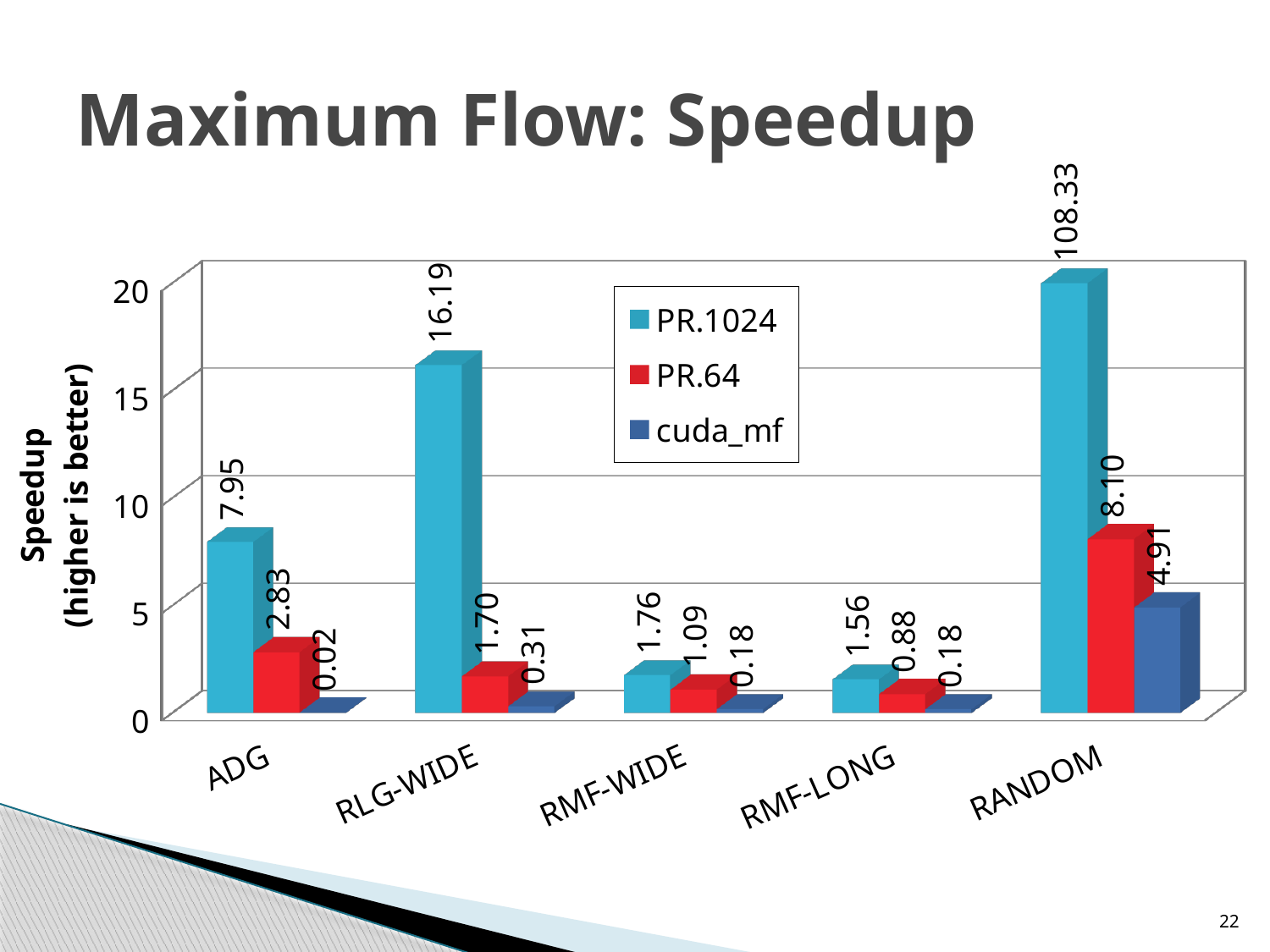
What is the label of the y axis? Speedup (higher is better) How many categories are shown on the x axis? 5 Is the PR.1024 speedup for ADG greater or less than 5? greater How many series does the legend list? 3 What kind of chart is shown on the slide? bar chart What is the difference between the PR.1024 and PR.64 speedups for RANDOM? 100.23 Which category has the lowest cuda_mf speedup? ADG What is the cuda_mf speedup for RANDOM? 4.91 What is the PR.64 speedup for ADG? 2.83 What is the PR.1024 speedup for RLG-WIDE? 16.19 Which category has the highest PR.1024 speedup? RANDOM Which is larger, the PR.64 speedup for RMF-WIDE or for RMF-LONG? RMF-WIDE